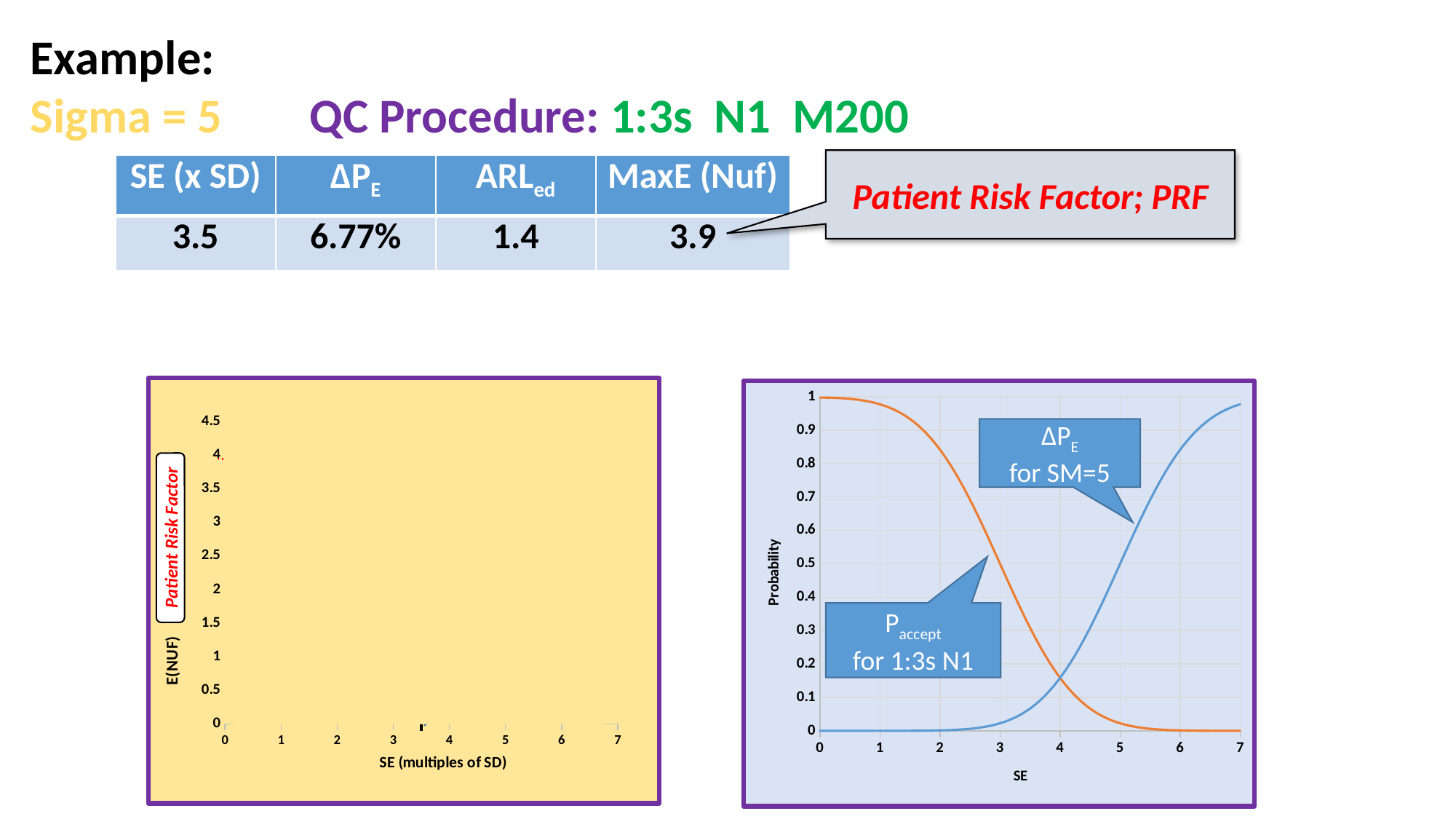
In the right-hand chart, is the value of the blue curve at SE = 3 greater or less than 0.2? less In the right-hand chart, how many curves are plotted? 2 In the right-hand chart, is the value of the blue curve at SE = 6 greater or less than 0.8? greater In the right-hand chart, at SE = 5, which curve has the higher value, the blue curve or the orange curve? blue curve What is the x-axis title of the left-hand chart? SE (multiples of SD) What kind of chart is the right-hand chart (Probability vs SE)? line chart In the right-hand chart, does the blue curve (ΔPE for SM=5) rise or fall as SE increases? rise In the right-hand chart, does the orange curve (P accept for 1:3s N1) rise or fall as SE increases? fall In the right-hand chart, is the value of the orange curve at SE = 5 greater or less than 0.2? less In the right-hand chart, at SE = 3, which curve has the higher value, the blue curve or the orange curve? orange curve What is the y-axis title of the right-hand chart? Probability